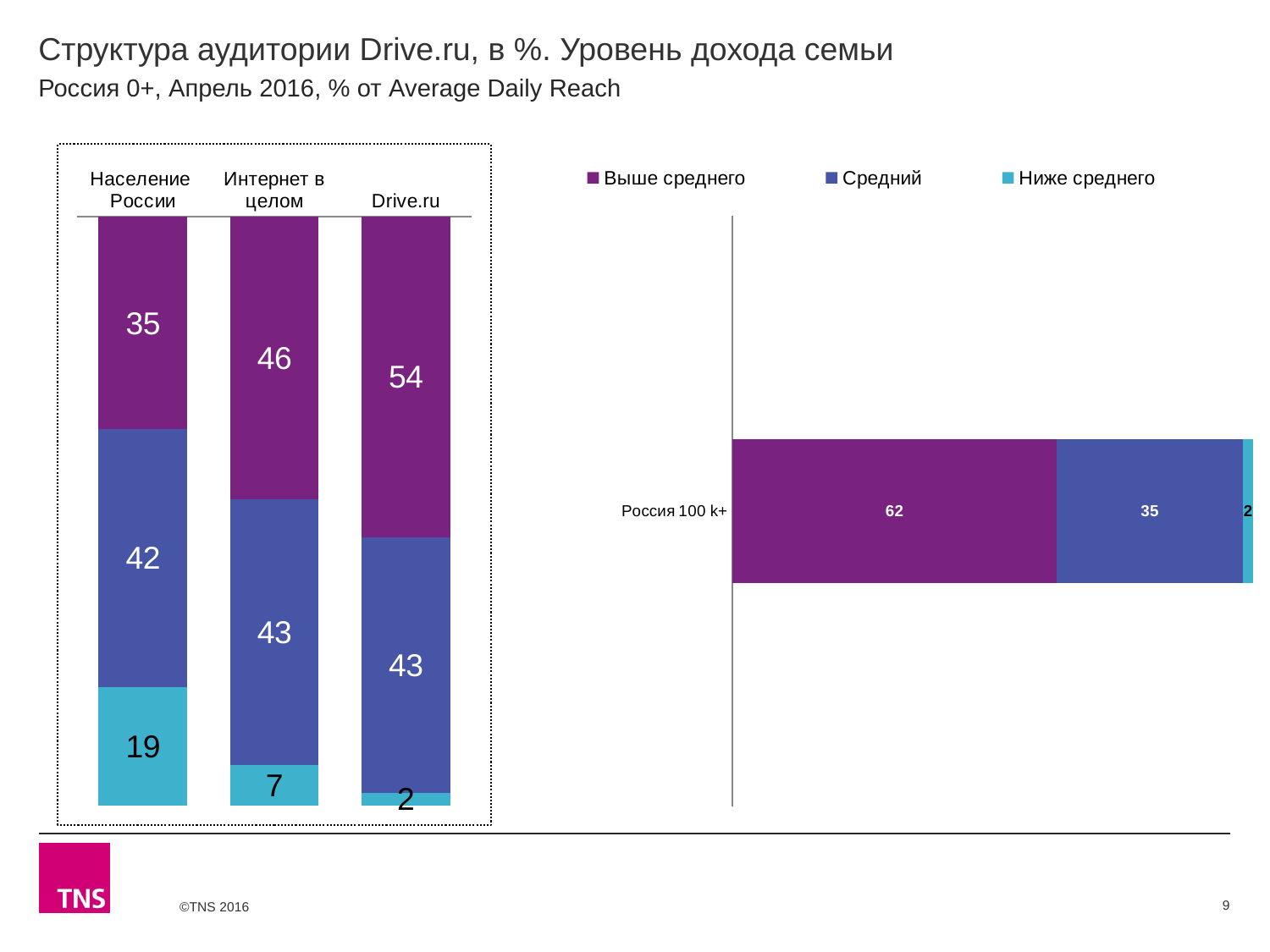
In the left stacked bar chart, which is larger: the 'Ниже среднего' value for Население России or for Интернет в целом? Население России In the left stacked bar chart, what is the difference between the 'Выше среднего' values for Drive.ru and Население России? 19 In the left stacked bar chart, which category has the lowest 'Ниже среднего' value? Drive.ru In the left stacked bar chart, which category has the highest 'Выше среднего' value? Drive.ru In the left stacked bar chart, what is the value of the 'Средний' segment for Интернет в целом? 43 In the left stacked bar chart, what is the value of the 'Ниже среднего' segment for Население России? 19 In the right horizontal bar chart, what is the value of the 'Выше среднего' segment for Россия 100 k+? 62 In the left stacked bar chart, what is the value of the 'Выше среднего' segment for Drive.ru? 54 How many series does the legend list? 3 How many categories are shown in the left stacked bar chart? 3 In the right horizontal bar chart, what is the value of the 'Средний' segment for Россия 100 k+? 35 What type of chart is the chart on the right side of the slide? Bar chart